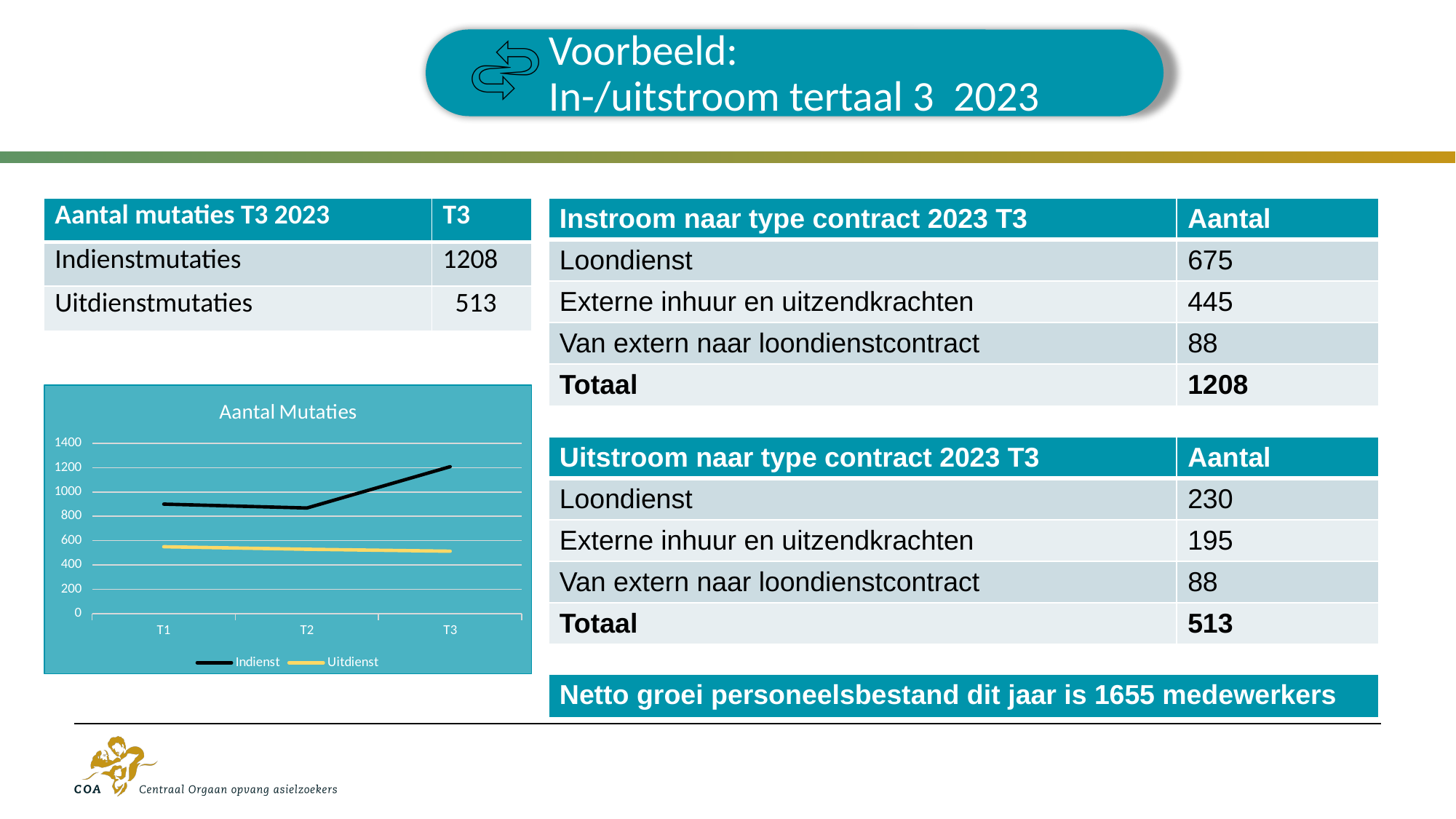
In the chart, is the Uitdienst value at T3 greater or less than 400? greater How many points are plotted along the x axis of the chart? 3 What is the title of the chart on the slide? Aantal Mutaties At which point on the x axis does the Indienst series reach its highest value? T3 At T3, which series has the larger value, Indienst or Uitdienst? Indienst In the chart, is the Indienst value at T2 greater or less than 1000? less Which colour is used for the Uitdienst series in the chart? yellow How many series does the chart's legend list? 2 In the chart, is the Indienst value at T1 greater or less than 800? greater Does the Indienst series rise or fall from T2 to T3? rise What kind of chart is shown on the slide? line chart